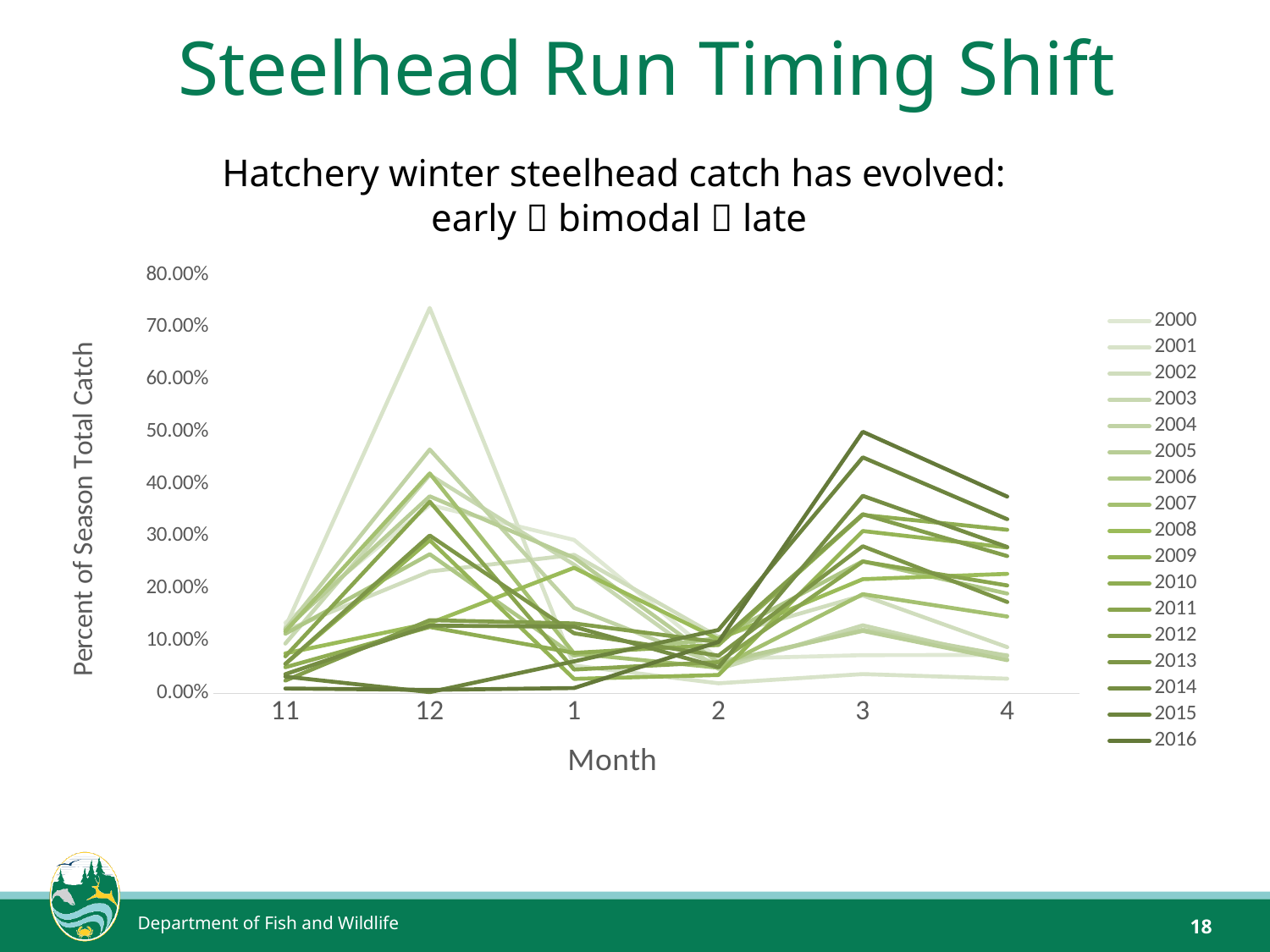
What is the label of the y axis? Percent of Season Total Catch Is the highest value plotted at month 12 greater or less than 60%? greater What kind of chart is shown on the slide? Line chart Is the highest value plotted at month 4 greater or less than 30%? greater What is the label of the x axis? Month How many series does the legend list? 17 Is the highest value plotted at month 2 greater or less than 20%? less What is the maximum value shown on the y axis? 80.00% At which month does the highest value on the chart occur? 12 How many months are shown along the x axis? 6